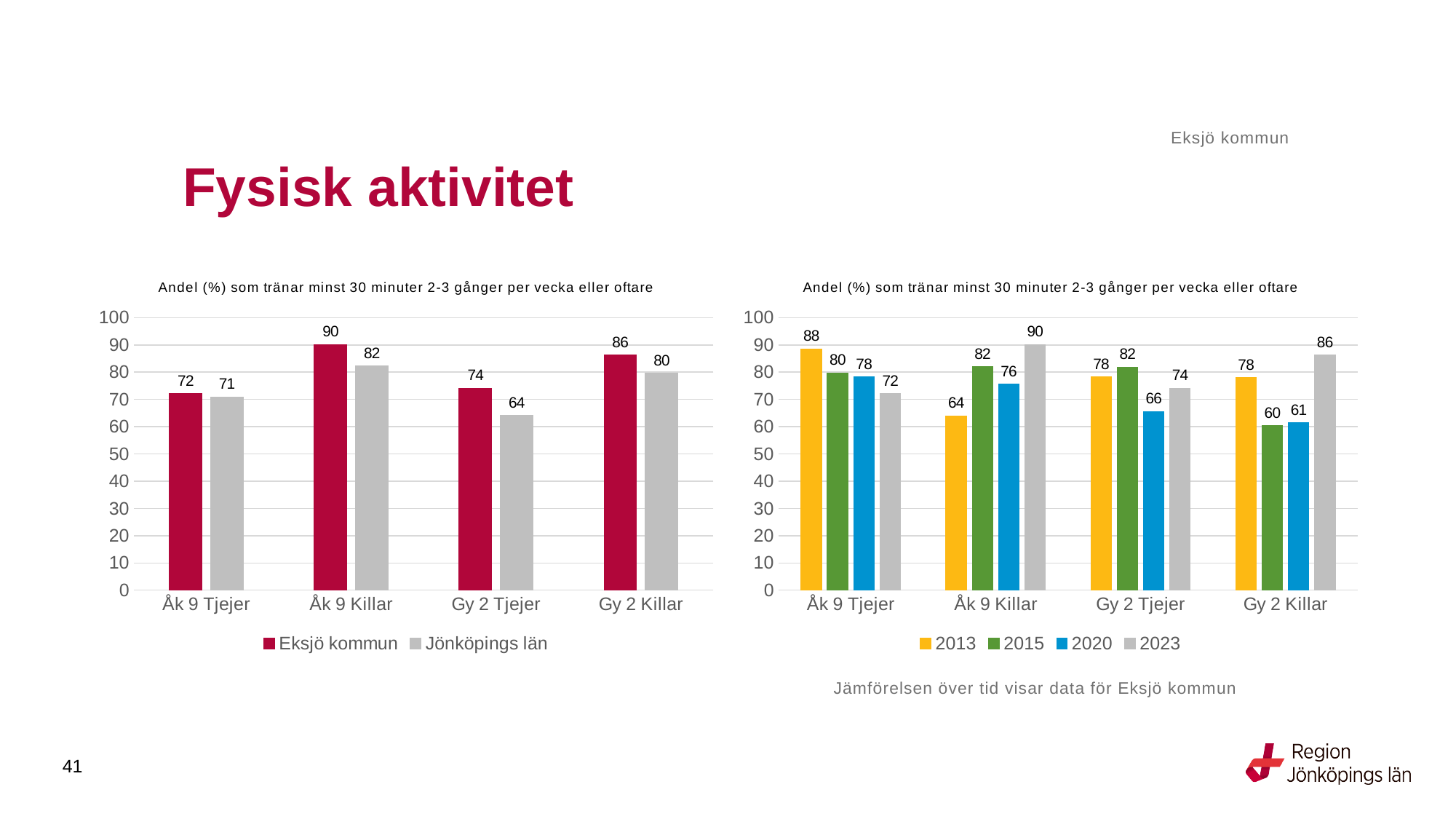
In the right chart, what is the value for 2020 for Gy 2 Tjejer? 66 In the left chart, what is the difference between Eksjö kommun and Jönköpings län for Gy 2 Tjejer? 10 What kind of chart is the left chart? Bar chart In the left chart, which category has the lowest value for Jönköpings län? Gy 2 Tjejer In the left chart, what is the value for Jönköpings län for Gy 2 Tjejer? 64 In the right chart, which year has the highest value for Åk 9 Killar? 2023 In the left chart, what is the value for Eksjö kommun for Åk 9 Killar? 90 In the left chart, how many series does the legend list? 2 In the right chart, how many series does the legend list? 4 In the right chart, what is the value for 2013 for Åk 9 Tjejer? 88 In the right chart, what is the difference between the 2013 and 2023 values for Åk 9 Killar? 26 In the right chart, which is larger for Gy 2 Killar: the value for 2013 or the value for 2015? 2013